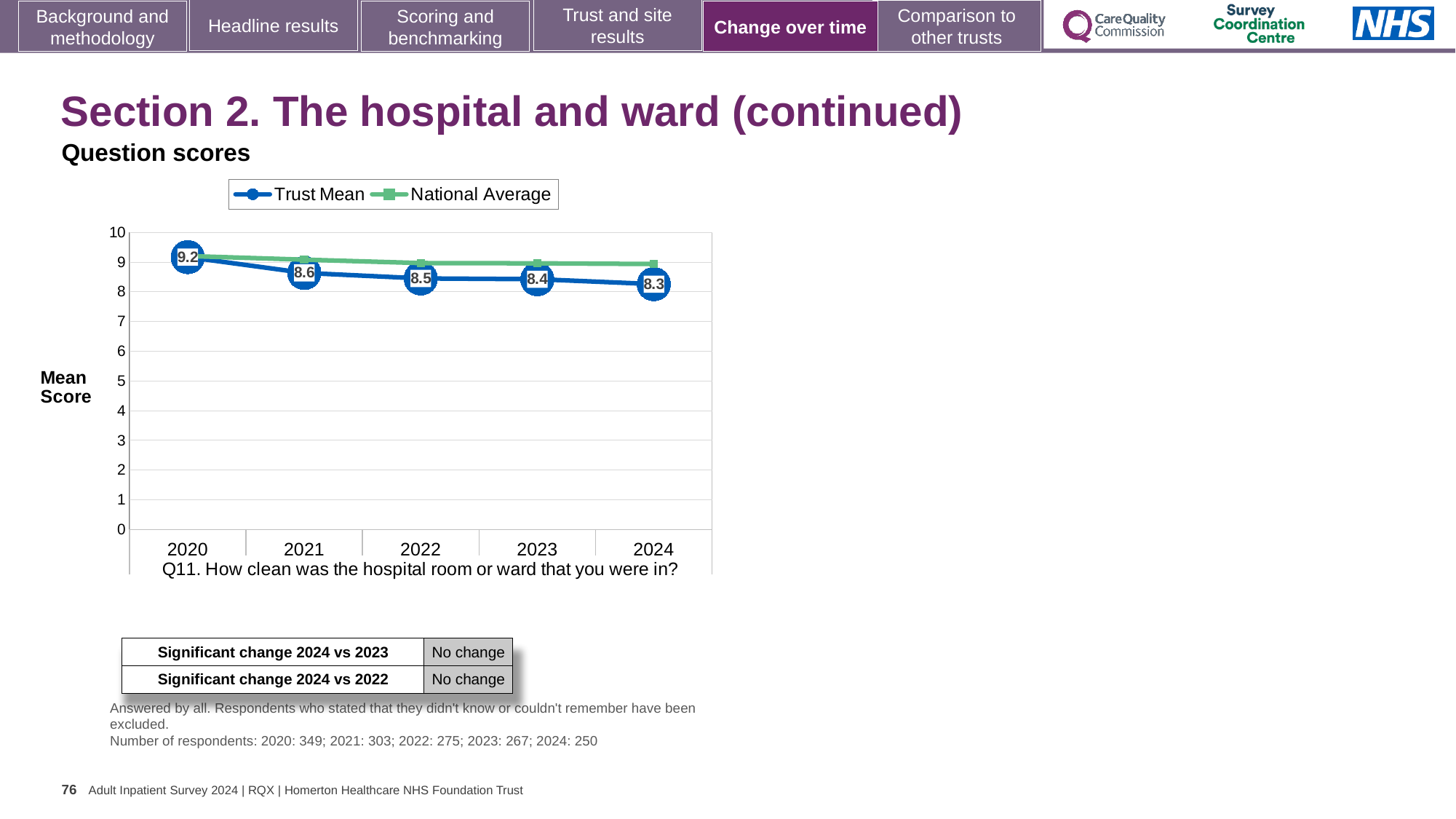
In which year is the Trust Mean lowest? 2024 Which is larger, the Trust Mean in 2021 or in 2023? 2021 What is the Trust Mean value for 2020? 9.2 What is the Trust Mean value for 2024? 8.3 Is the National Average value for 2024 greater or less than 8? greater In which year is the Trust Mean highest? 2020 How many series does the legend list? 2 What is the difference between the Trust Mean in 2020 and in 2024? 0.9 What is the Trust Mean value for 2022? 8.5 How many years are plotted on the x axis? 5 What kind of chart is shown? Line chart Does the Trust Mean rise or fall from 2020 to 2024? Fall